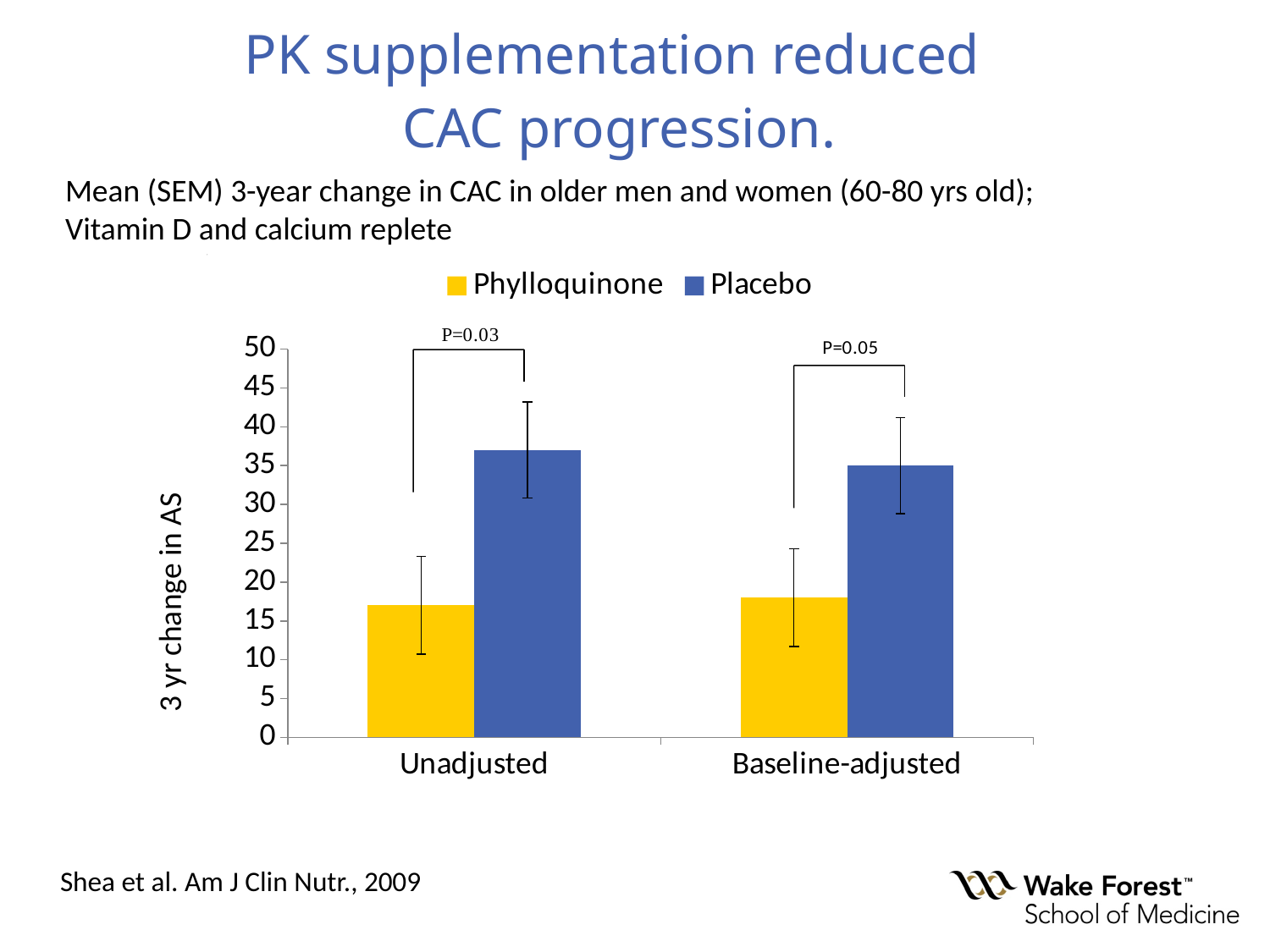
How many categories are shown on the x axis? 2 Is the Phylloquinone value for Baseline-adjusted greater or less than 25? less Is the Phylloquinone value for Unadjusted greater or less than 20? less In the Unadjusted category, which is larger: the Phylloquinone bar or the Placebo bar? Placebo Which series has the lowest bar in the Unadjusted category? Phylloquinone How many series does the legend list? 2 In the Baseline-adjusted category, which is larger: the Phylloquinone bar or the Placebo bar? Placebo What is the label on the y axis of the chart? 3 yr change in AS What kind of chart is shown on the slide? bar chart Is the Placebo value for Unadjusted greater or less than 30? greater What P value is shown above the Unadjusted bars? P=0.03